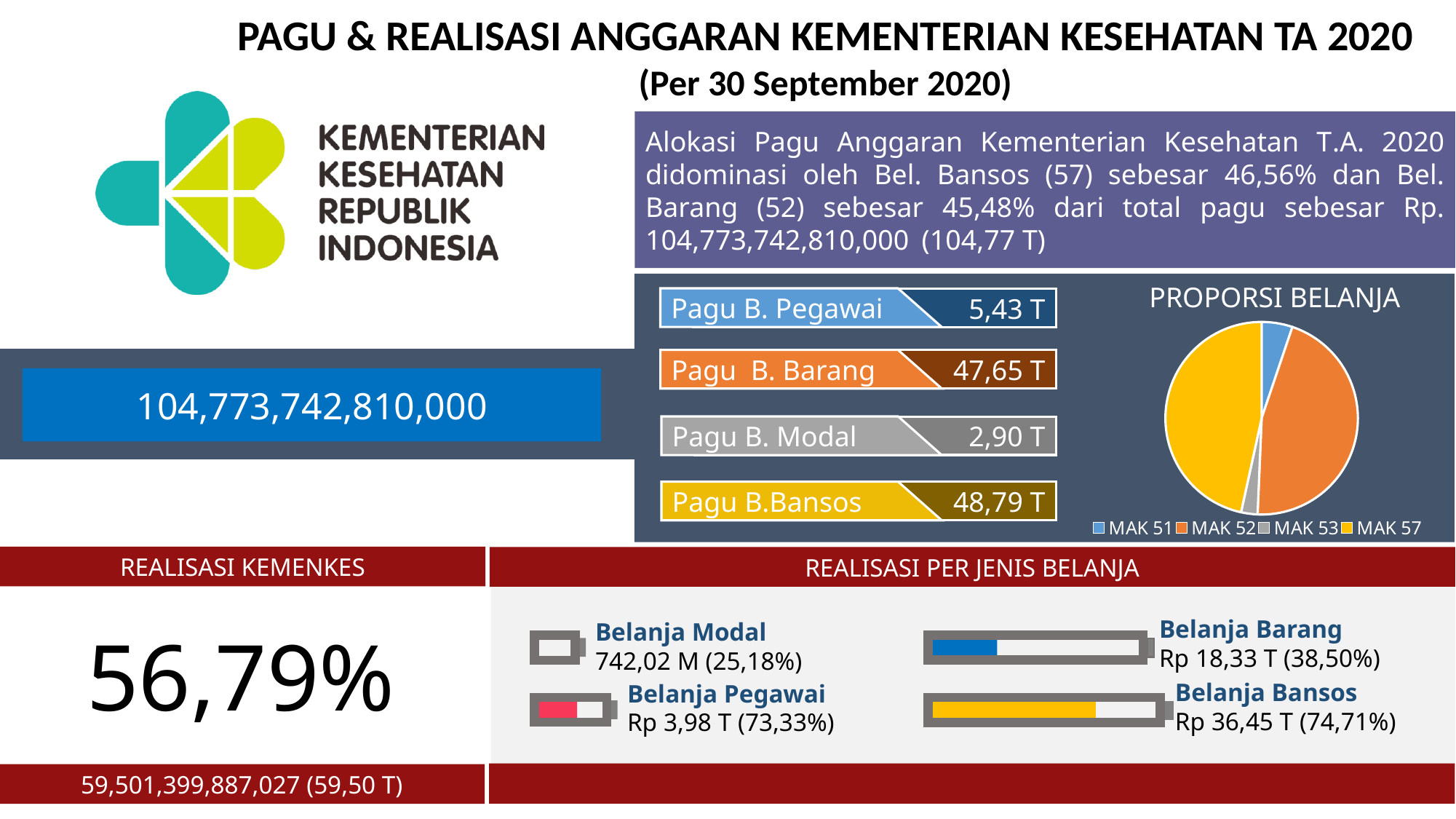
In the PROPORSI BELANJA pie chart, which slice is larger, MAK 51 or MAK 53? MAK 51 What kind of chart is the PROPORSI BELANJA chart? pie chart What share of the total pagu does Bel. Bansos (MAK 57) represent, according to the slide? 46,56% In the PROPORSI BELANJA pie chart, which slice is larger, MAK 52 or MAK 51? MAK 52 What is the Pagu B. Modal value shown next to the PROPORSI BELANJA pie chart? 2,90 T What are the legend entries of the PROPORSI BELANJA pie chart? MAK 51, MAK 52, MAK 53, MAK 57 In the PROPORSI BELANJA pie chart, which slice is the smallest? MAK 53 How many entries does the legend of the PROPORSI BELANJA pie chart list? 4 What is the Pagu B. Bansos value shown next to the PROPORSI BELANJA pie chart? 48,79 T What is the difference between Pagu B. Barang and Pagu B. Pegawai shown next to the PROPORSI BELANJA pie chart? 42,22 T What share of the total pagu does Bel. Barang (MAK 52) represent, according to the slide? 45,48% What colour is the MAK 57 slice in the PROPORSI BELANJA pie chart? yellow